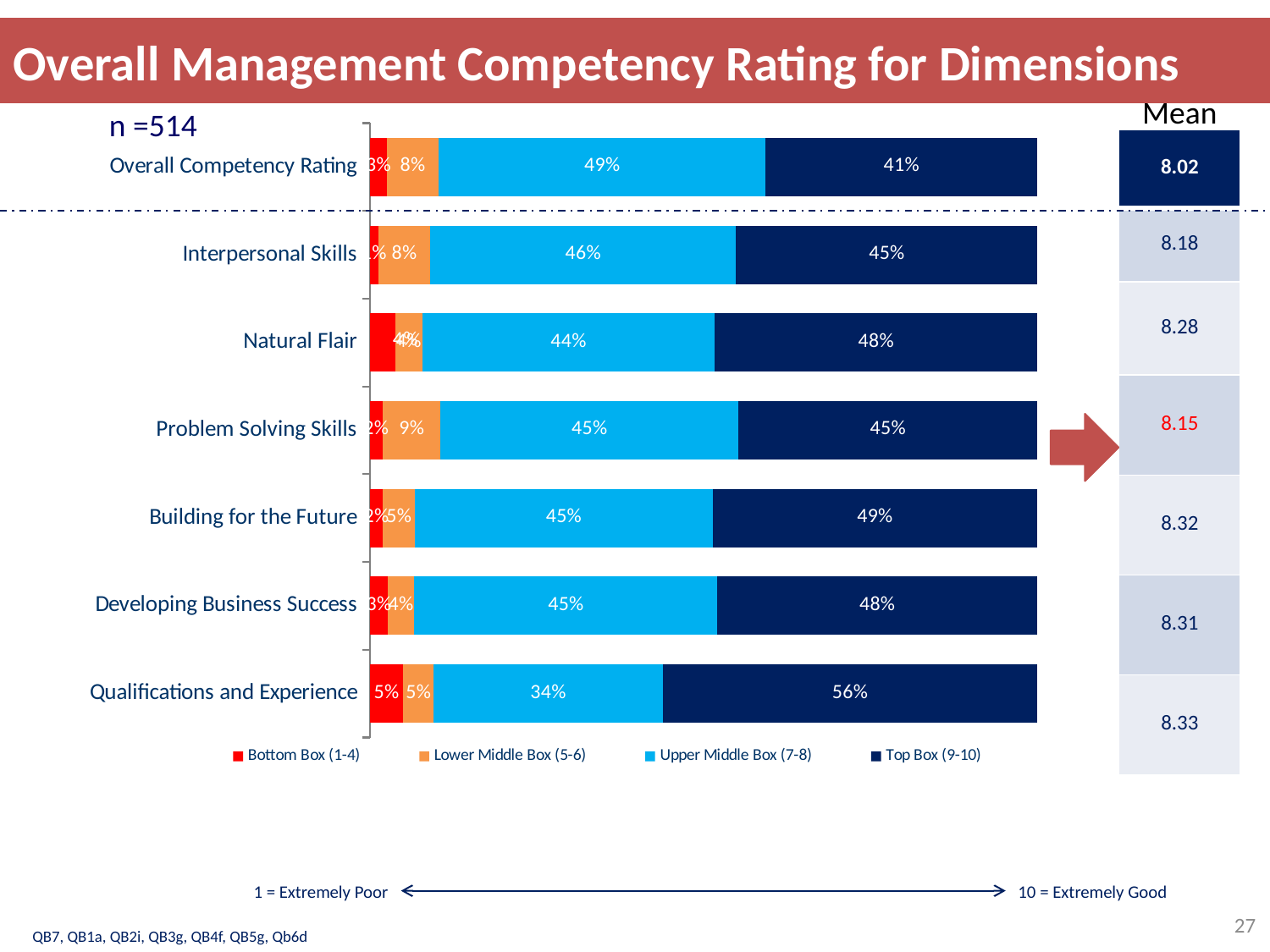
What is the Top Box (9-10) value for Qualifications and Experience? 56% How many series does the chart legend list? 4 Which legend entry is shown in dark navy blue? Top Box (9-10) How many dimensions (categories) are plotted in the chart? 7 What sample size (n) is shown for the chart? n = 514 What kind of chart is shown on the slide? Stacked bar chart Which dimension has the lowest Upper Middle Box (7-8) value? Qualifications and Experience What is the Lower Middle Box (5-6) value for Problem Solving Skills? 9% Which dimension has the highest Top Box (9-10) value? Qualifications and Experience What is the difference between the Top Box (9-10) value for Qualifications and Experience and that for Overall Competency Rating? 15 percentage points What is the Upper Middle Box (7-8) value for Overall Competency Rating? 49% Which has the larger Top Box (9-10) value, Interpersonal Skills or Natural Flair? Natural Flair